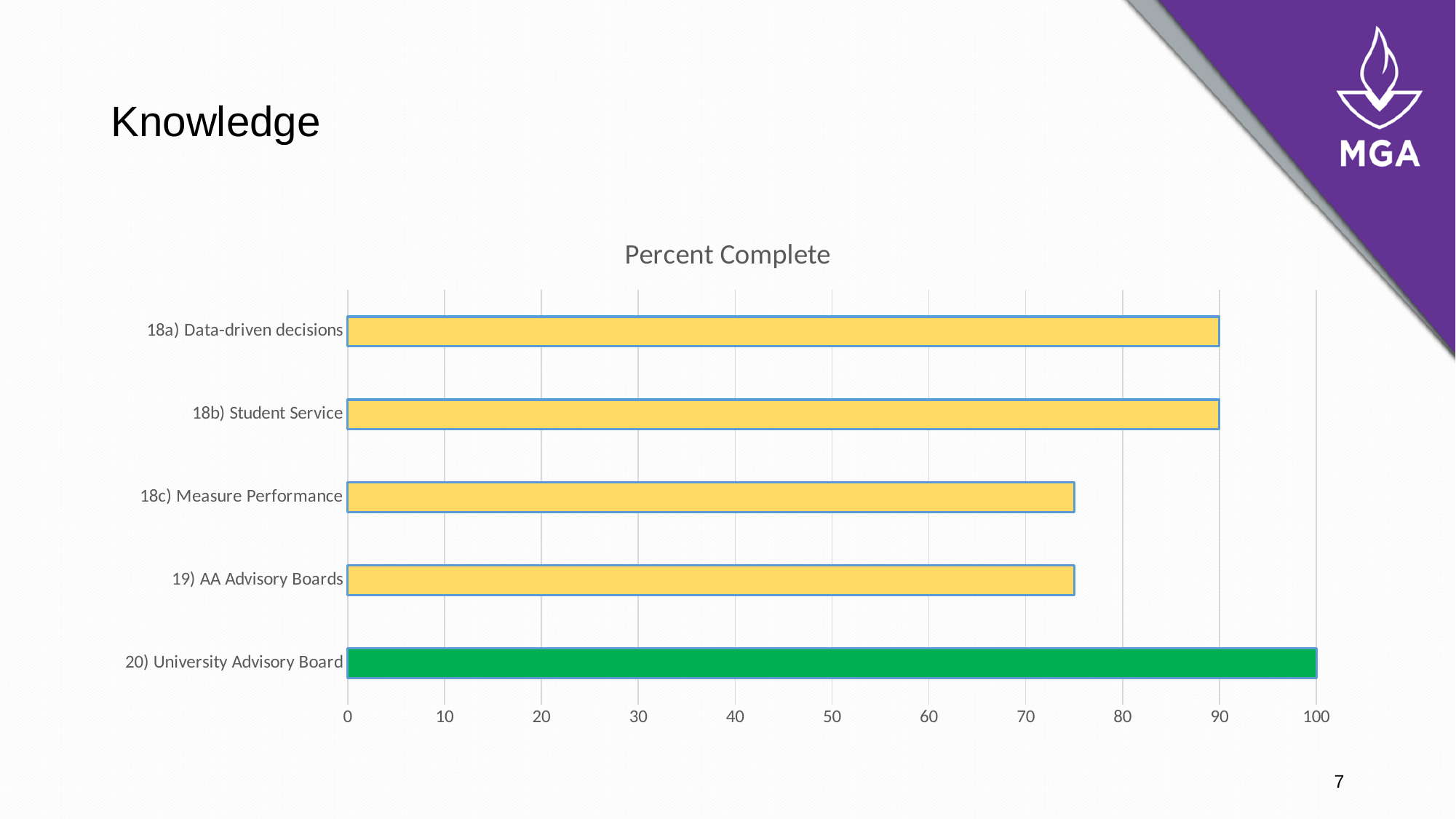
What is the value for 20) University Advisory Board? 100 Is the value for 19) AA Advisory Boards greater or less than 80? less What type of chart is shown on the slide? bar chart What is the value for 18a) Data-driven decisions? 90 What is the title of the chart? Percent Complete Which is larger, the value for 20) University Advisory Board or the value for 19) AA Advisory Boards? 20) University Advisory Board What colour is the bar for 20) University Advisory Board? green What is the value for 18b) Student Service? 90 Which is larger, the value for 18a) Data-driven decisions or the value for 18c) Measure Performance? 18a) Data-driven decisions Is the value for 18c) Measure Performance greater or less than 70? greater How many categories are plotted in the chart? 5 Which category has the highest value? 20) University Advisory Board